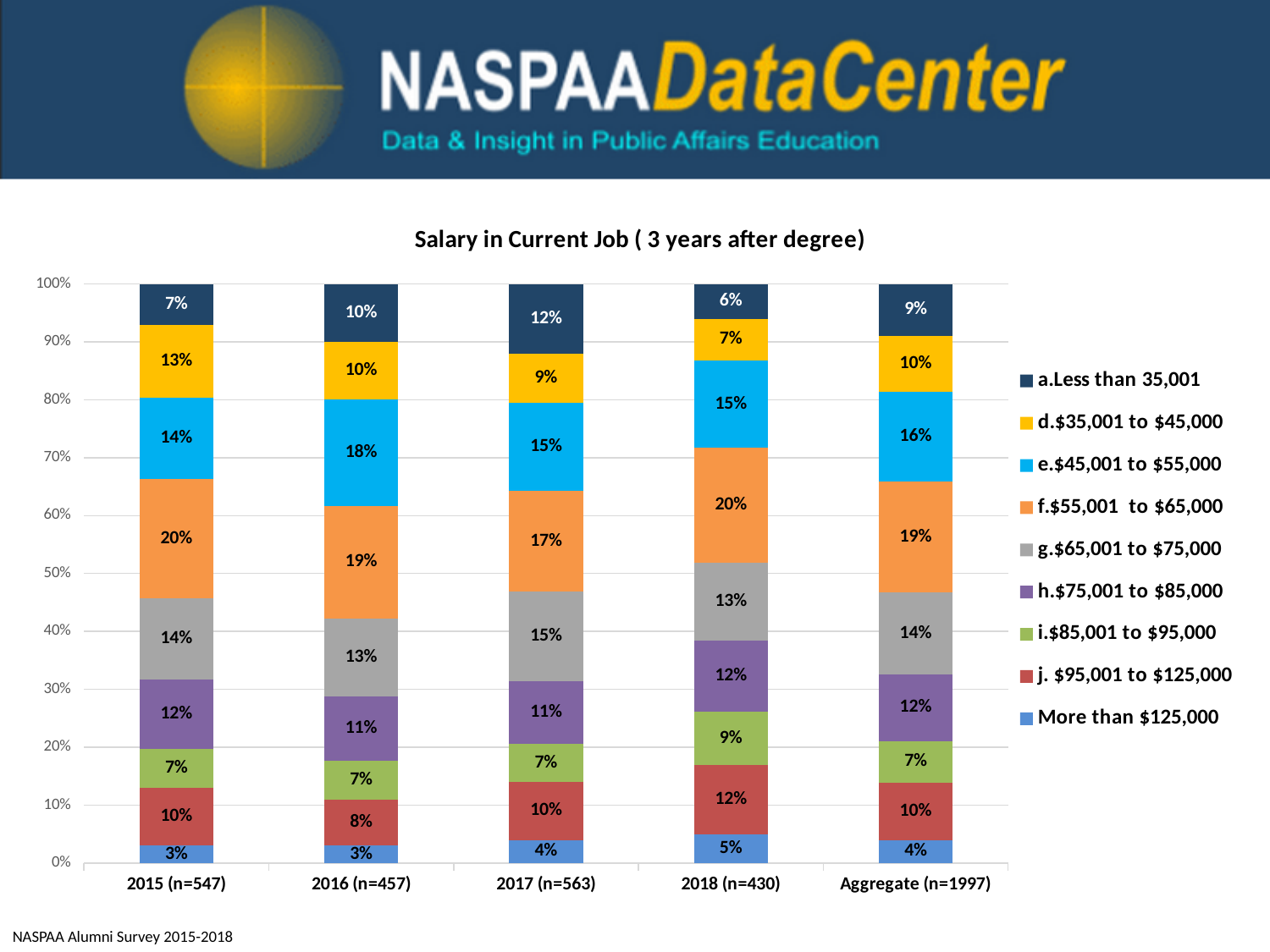
What is the Aggregate (n=1997) share for the $45,001 to $55,000 salary band? 16% What percentage of 2015 (n=547) respondents earned $55,001 to $65,000? 20% What is the difference between the $35,001 to $45,000 share in 2015 (n=547) and in 2018 (n=430)? 6% How many salary bands does the legend list? 9 Which year group has the highest share of respondents earning less than 35,001? 2017 (n=563) What is the title of the chart? Salary in Current Job ( 3 years after degree) What percentage of 2018 (n=430) respondents earned more than $125,000? 5% How many year groups (bars) are shown on the x axis? 5 What type of chart is shown on the slide? Stacked bar chart Which is larger: the $45,001 to $55,000 share in 2016 (n=457) or in 2017 (n=563)? 2016 (n=457) Which year group has the lowest share of respondents earning less than 35,001? 2018 (n=430) What percentage of 2016 (n=457) respondents earned $95,001 to $125,000? 8%